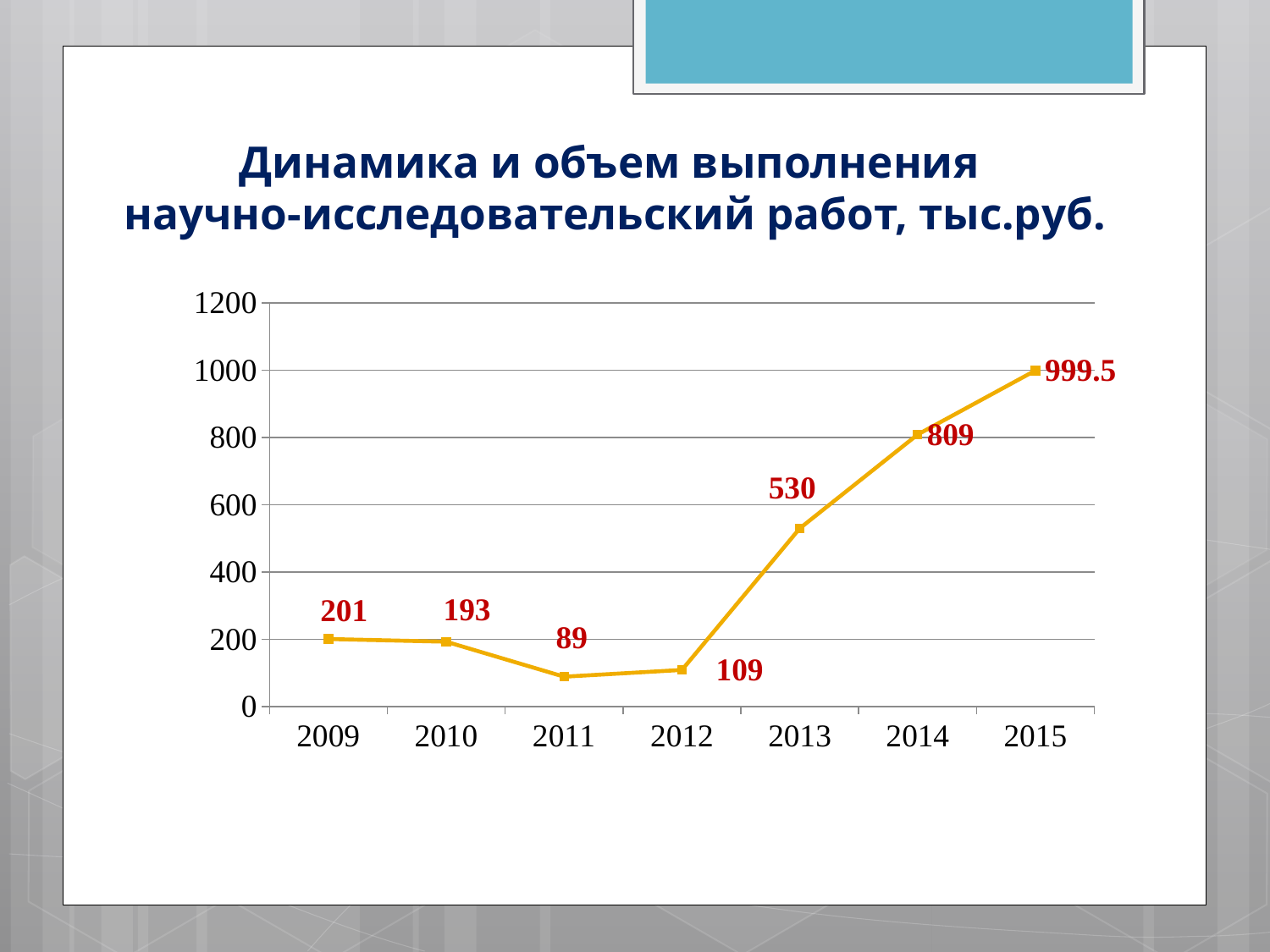
Which year has the highest value? 2015 What kind of chart is shown on the slide? line chart What is the difference between the values for 2009 and 2010? 8 Which is larger, the value for 2012 or the value for 2011? 2012 Which year has the lowest value? 2011 What is the difference between the values for 2014 and 2013? 279 What is the value for 2013? 530 Do the values rise or fall from 2012 to 2015? rise What is the value for 2015? 999.5 How many years are plotted on the chart? 7 Is the value for 2014 greater or less than 600? greater What is the value for 2011? 89